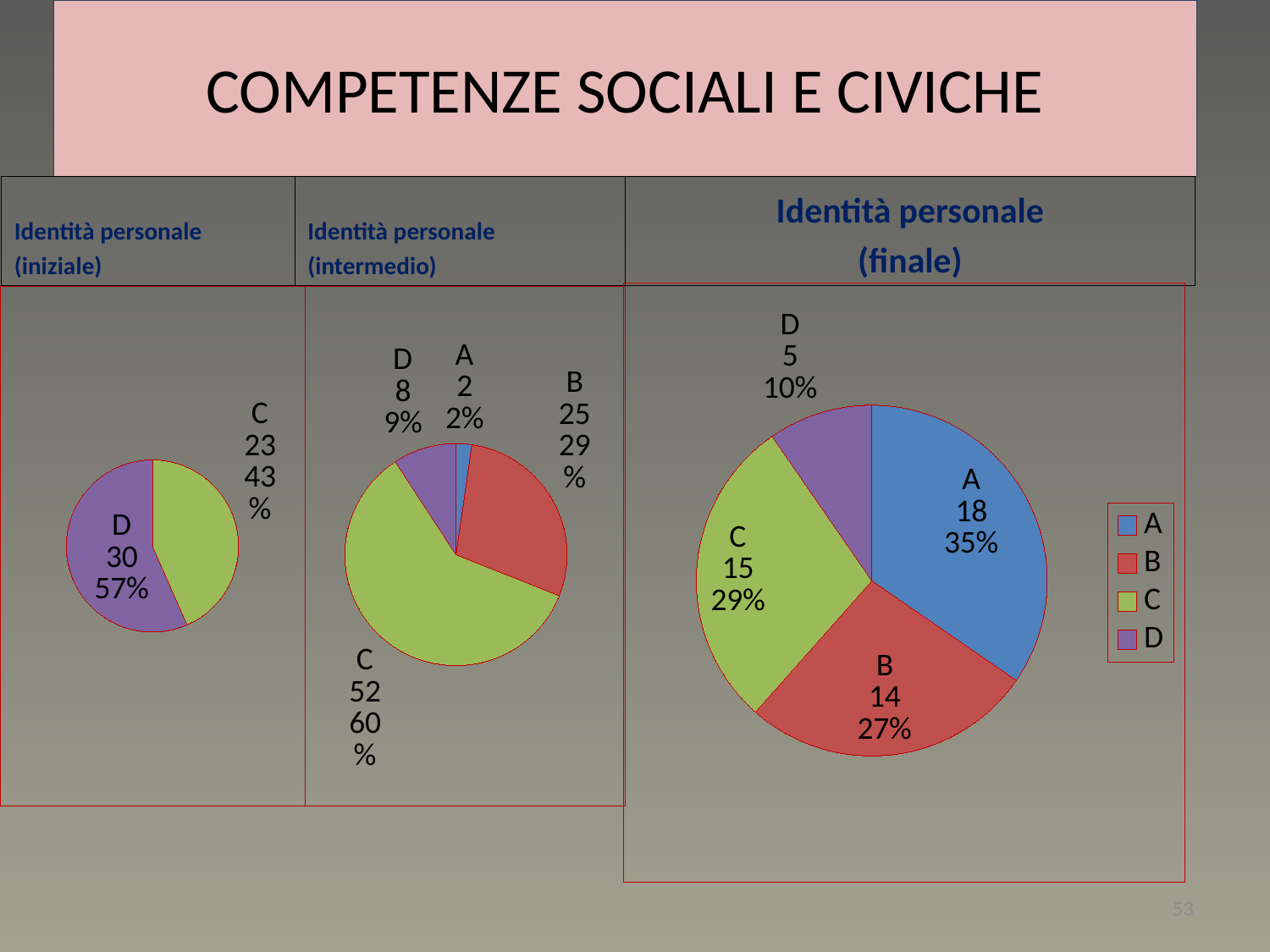
In the 'Identità personale (finale)' pie chart, what value is shown for category A? 18 In the 'Identità personale (finale)' pie chart, what is the difference between the values for A and B? 4 How many slices does the 'Identità personale (iniziale)' pie chart have? 2 In the 'Identità personale (iniziale)' pie chart, what percentage share does category C have? 43% What type of chart is used for 'Identità personale (finale)'? Pie chart In the 'Identità personale (intermedio)' pie chart, which category has the largest slice? C In the 'Identità personale (intermedio)' pie chart, what value is shown for category B? 25 In the 'Identità personale (finale)' pie chart, how many categories does the legend list? 4 In the 'Identità personale (iniziale)' pie chart, what value is shown for category D? 30 In the 'Identità personale (intermedio)' pie chart, what percentage share does category D have? 9% In the 'Identità personale (intermedio)' pie chart, which category has the smallest slice? A In the 'Identità personale (finale)' pie chart, which category has the largest slice? A